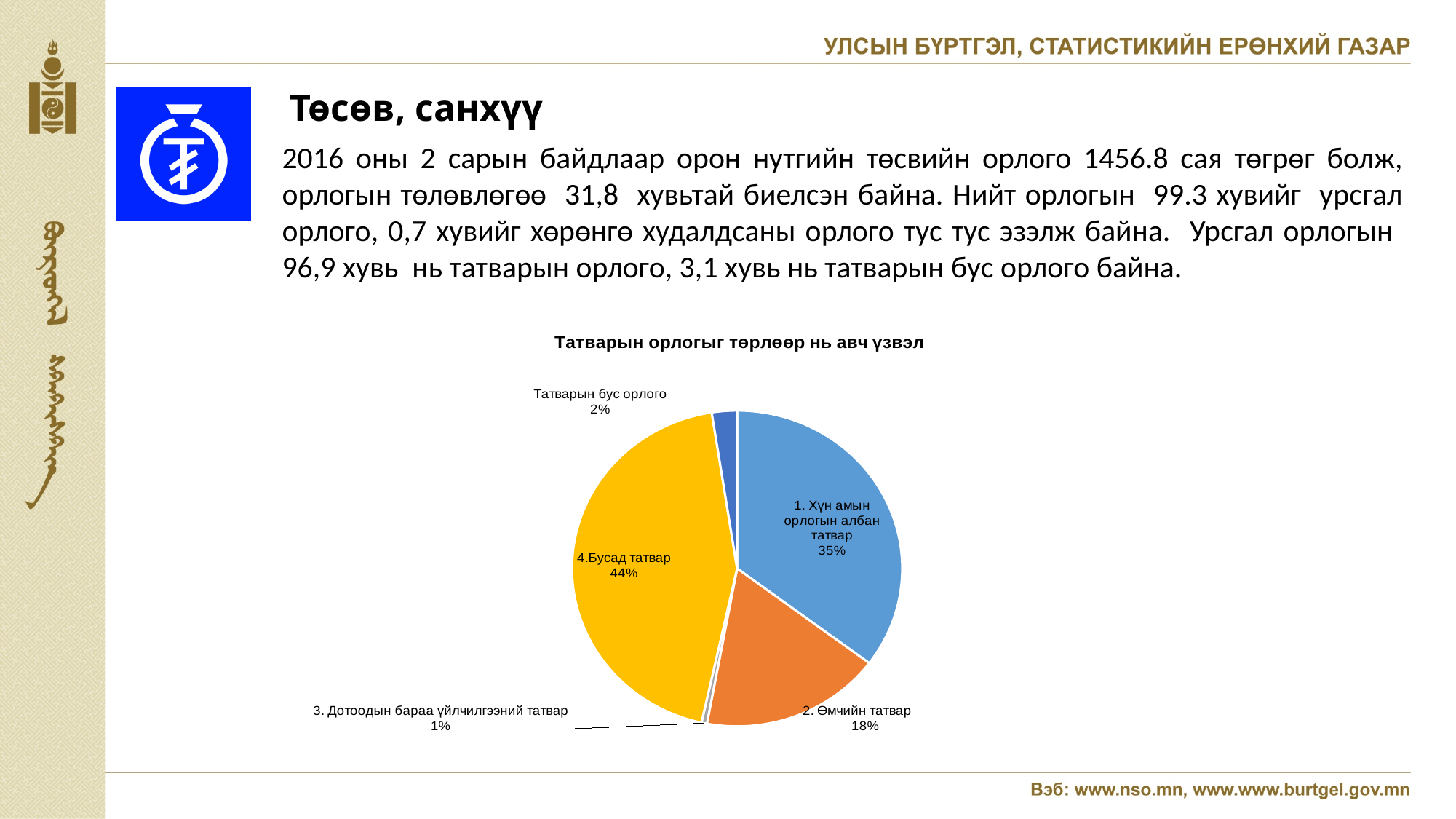
What share of the pie does "1. Хүн амын орлогын албан татвар" have? 35% What is the title of the pie chart? Татварын орлогыг төрлөөр нь авч үзвэл What kind of chart is shown on the slide? pie chart What share of the pie does "4.Бусад татвар" have? 44% What is the difference in percentage points between "4.Бусад татвар" and "1. Хүн амын орлогын албан татвар"? 9 What share of the pie does "3. Дотоодын бараа үйлчилгээний татвар" have? 1% Which slice of the pie chart is the smallest? 3. Дотоодын бараа үйлчилгээний татвар How many slices does the pie chart have? 5 Which is larger, the share for "2. Өмчийн татвар" or the share for "Татварын бус орлого"? 2. Өмчийн татвар Which slice of the pie chart is the largest? 4.Бусад татвар